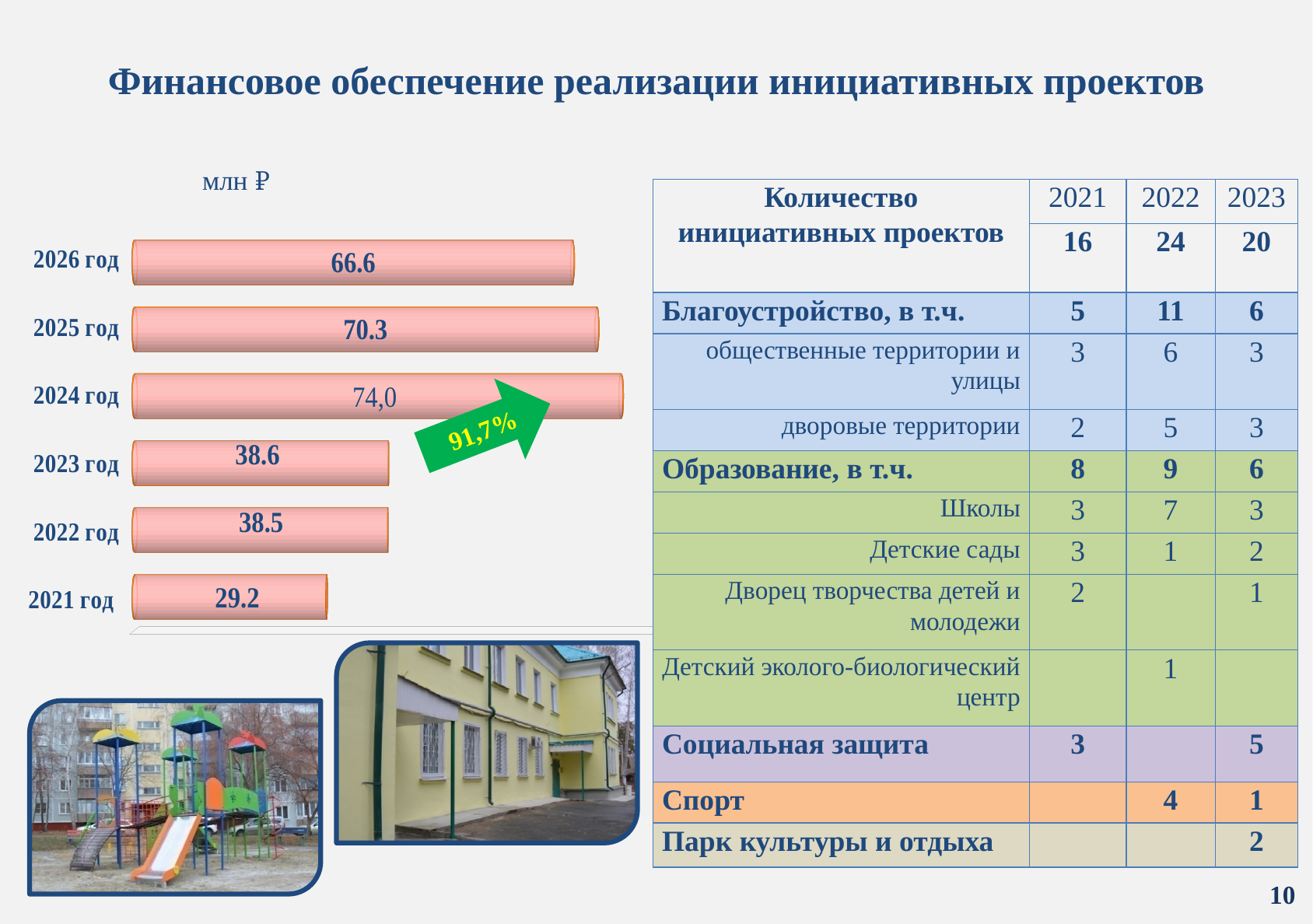
Which is larger in the bar chart, the value for 2025 год or for 2026 год? 2025 год Do the values in the bar chart rise or fall from 2021 год to 2024 год? rise What is the difference between the values for 2024 год and 2023 год in the bar chart? 35.4 What is the value for 2024 год in the bar chart? 74,0 What unit label is shown above the bar chart? млн ₽ Which year has the lowest value in the bar chart? 2021 год What is the value for 2021 год in the bar chart? 29.2 Which year has the highest value in the bar chart? 2024 год What type of chart is shown on the left of the slide? bar chart How many years (bars) are shown in the bar chart? 6 What is the value for 2023 год in the bar chart? 38.6 What is the value for 2026 год in the bar chart? 66.6